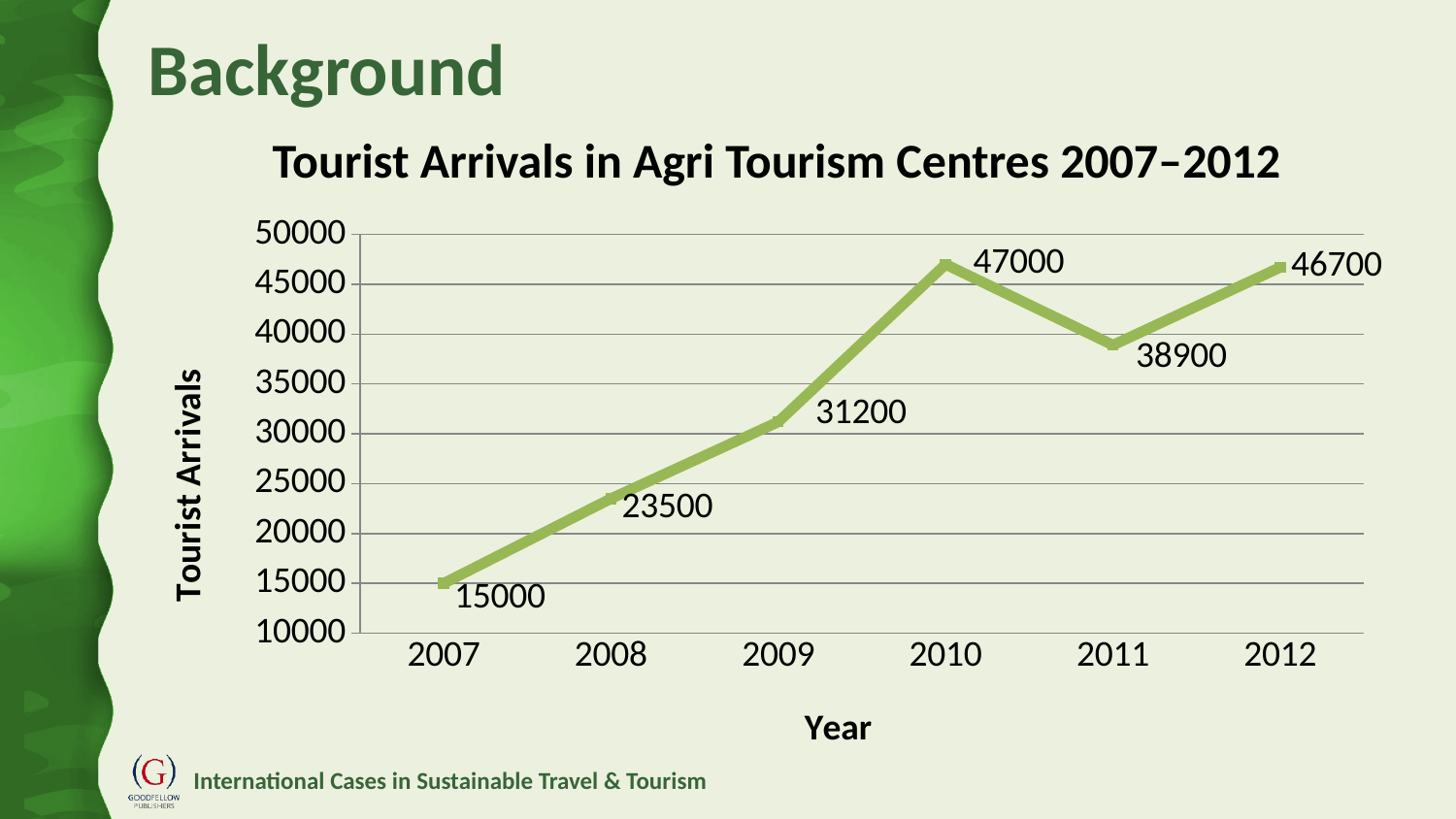
Which year has the highest number of tourist arrivals? 2010 What is the value for 2011? 38900 How many tourist arrivals were there in 2009? 31200 What is the difference in tourist arrivals between 2008 and 2007? 8500 Is the value for 2008 greater or less than 25000? less Which year had more tourist arrivals, 2009 or 2012? 2012 What is the title of the chart? Tourist Arrivals in Agri Tourism Centres 2007–2012 What is the difference in tourist arrivals between 2010 and 2011? 8100 Which year has the lowest number of tourist arrivals? 2007 How many years are plotted on the x axis? 6 Do tourist arrivals rise or fall from 2007 to 2010? rise What kind of chart is shown on the slide? line chart